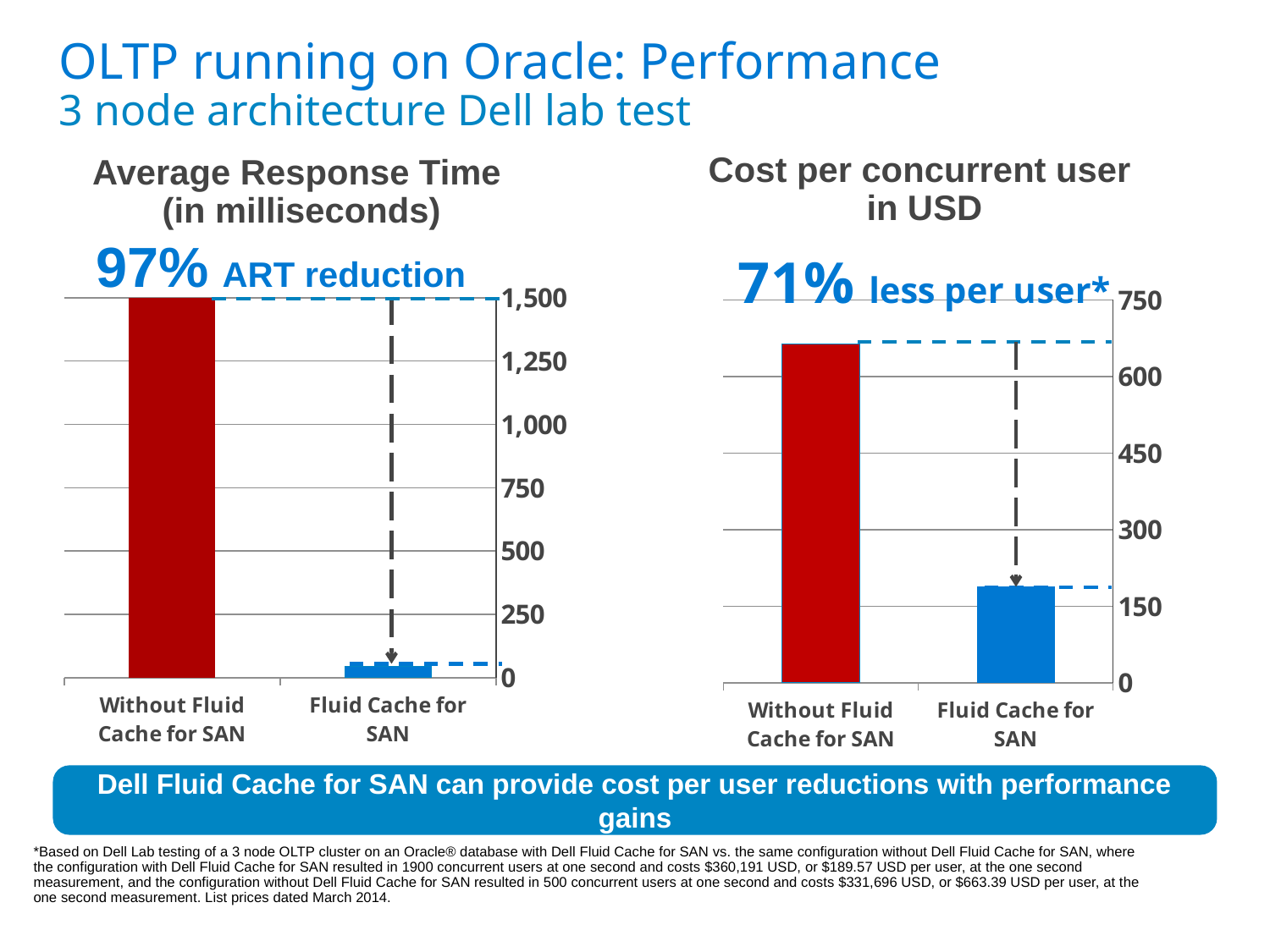
In the 'Cost per concurrent user in USD' chart, is the value for Without Fluid Cache for SAN greater or less than 600? greater In the 'Average Response Time (in milliseconds)' chart, is the value for Without Fluid Cache for SAN greater or less than 1,250? greater In the 'Cost per concurrent user in USD' chart, is the value for Fluid Cache for SAN greater or less than 300? less In the 'Average Response Time (in milliseconds)' chart, which category has the highest value? Without Fluid Cache for SAN What percentage reduction is annotated on the 'Average Response Time (in milliseconds)' chart? 97% ART reduction How many categories are shown in the 'Cost per concurrent user in USD' chart? 2 What kind of chart is the 'Average Response Time (in milliseconds)' chart? bar chart What is the highest axis tick shown on the 'Cost per concurrent user in USD' chart? 750 In the 'Cost per concurrent user in USD' chart, which category has the lowest value? Fluid Cache for SAN In the 'Cost per concurrent user in USD' chart, which is larger: Without Fluid Cache for SAN or Fluid Cache for SAN? Without Fluid Cache for SAN